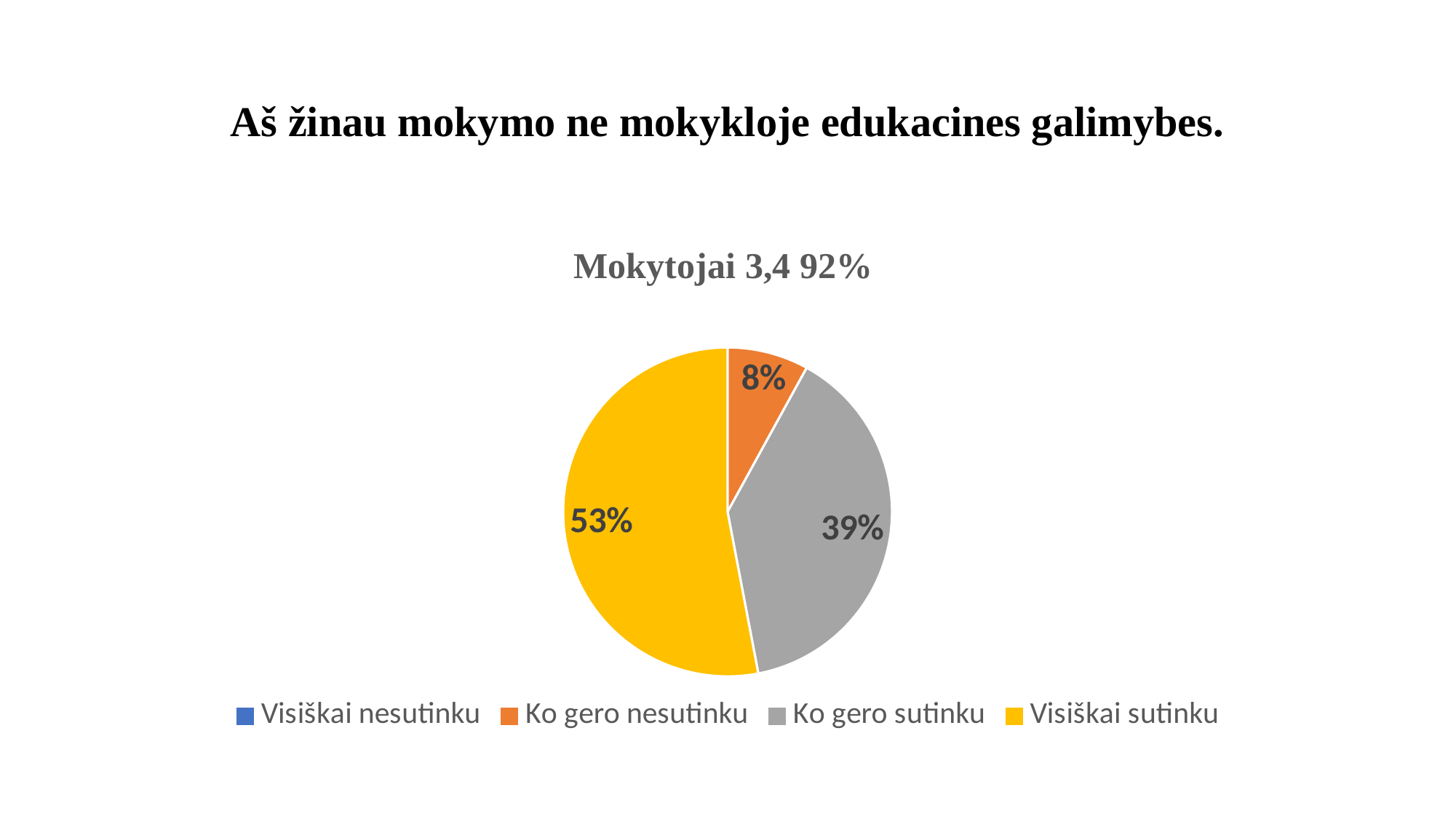
What is the chart's title? Mokytojai 3,4 92% What colour is the "Visiškai sutinku" slice? yellow Which is larger, the share of "Ko gero sutinku" or the share of "Ko gero nesutinku"? Ko gero sutinku What share of the pie does "Visiškai sutinku" take? 53% What share of the pie does "Ko gero sutinku" take? 39% How many entries does the legend list? 4 What is the difference between the shares of "Visiškai sutinku" and "Ko gero sutinku"? 14% Which category has the largest slice of the pie? Visiškai sutinku Which category with a visible slice has the smallest share of the pie? Ko gero nesutinku What is the combined share of "Ko gero sutinku" and "Visiškai sutinku"? 92% What share of the pie does "Ko gero nesutinku" take? 8% What kind of chart is shown on the slide? pie chart